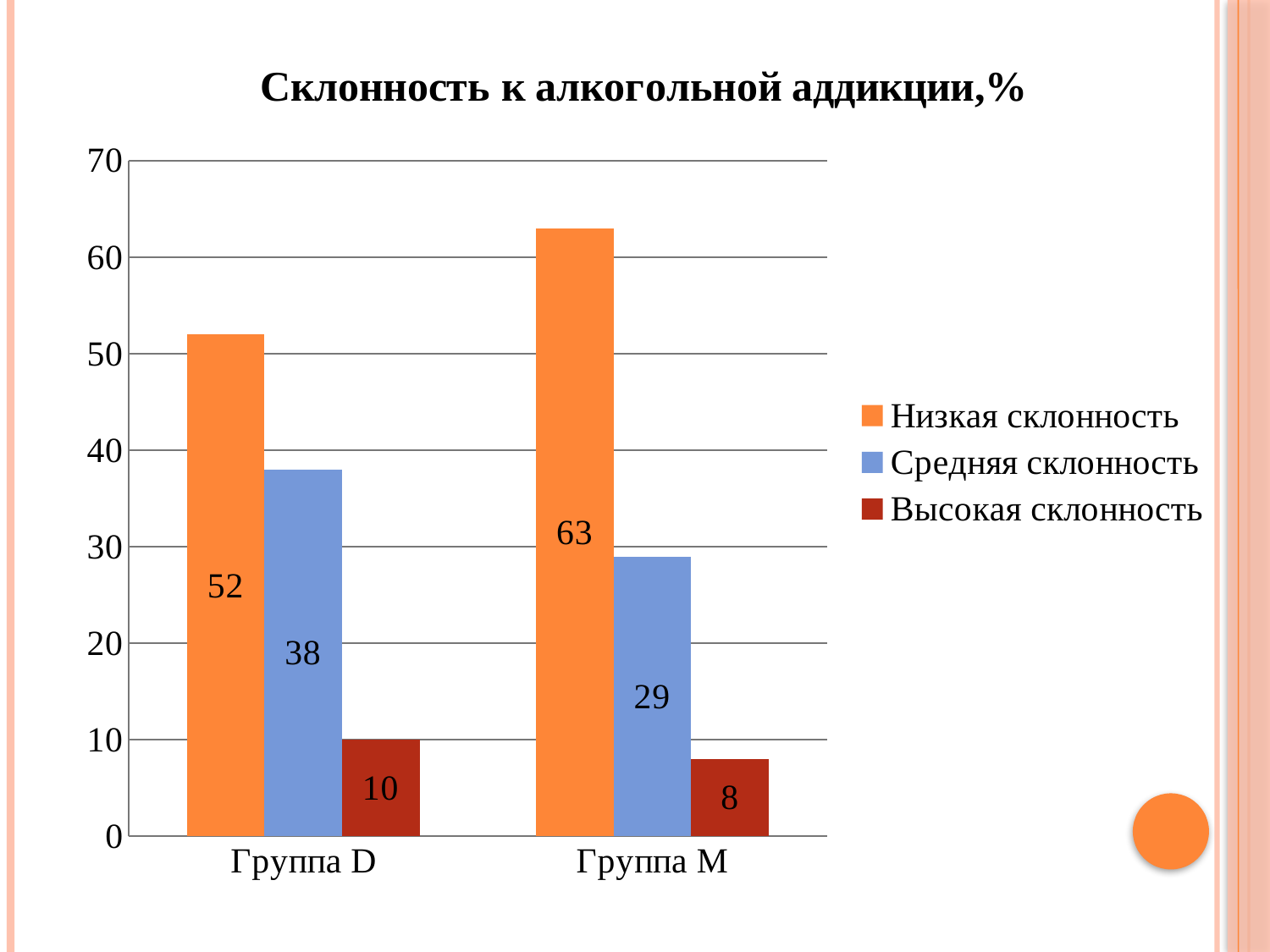
What is the difference between Средняя склонность for Группа D and Группа M? 9 Which series has the lowest value for Группа M? Высокая склонность How many series does the legend list? 3 How many groups are shown on the x axis? 2 What is the value of Высокая склонность for Группа D? 10 Which group has the higher value for Низкая склонность? Группа M What kind of chart is shown on the slide? Bar chart Which series has the highest value for Группа D? Низкая склонность What is the title of the chart? Склонность к алкогольной аддикции,% What is the value of Низкая склонность for Группа D? 52 What is the value of Средняя склонность for Группа M? 29 What is the difference between Низкая склонность for Группа M and Группа D? 11